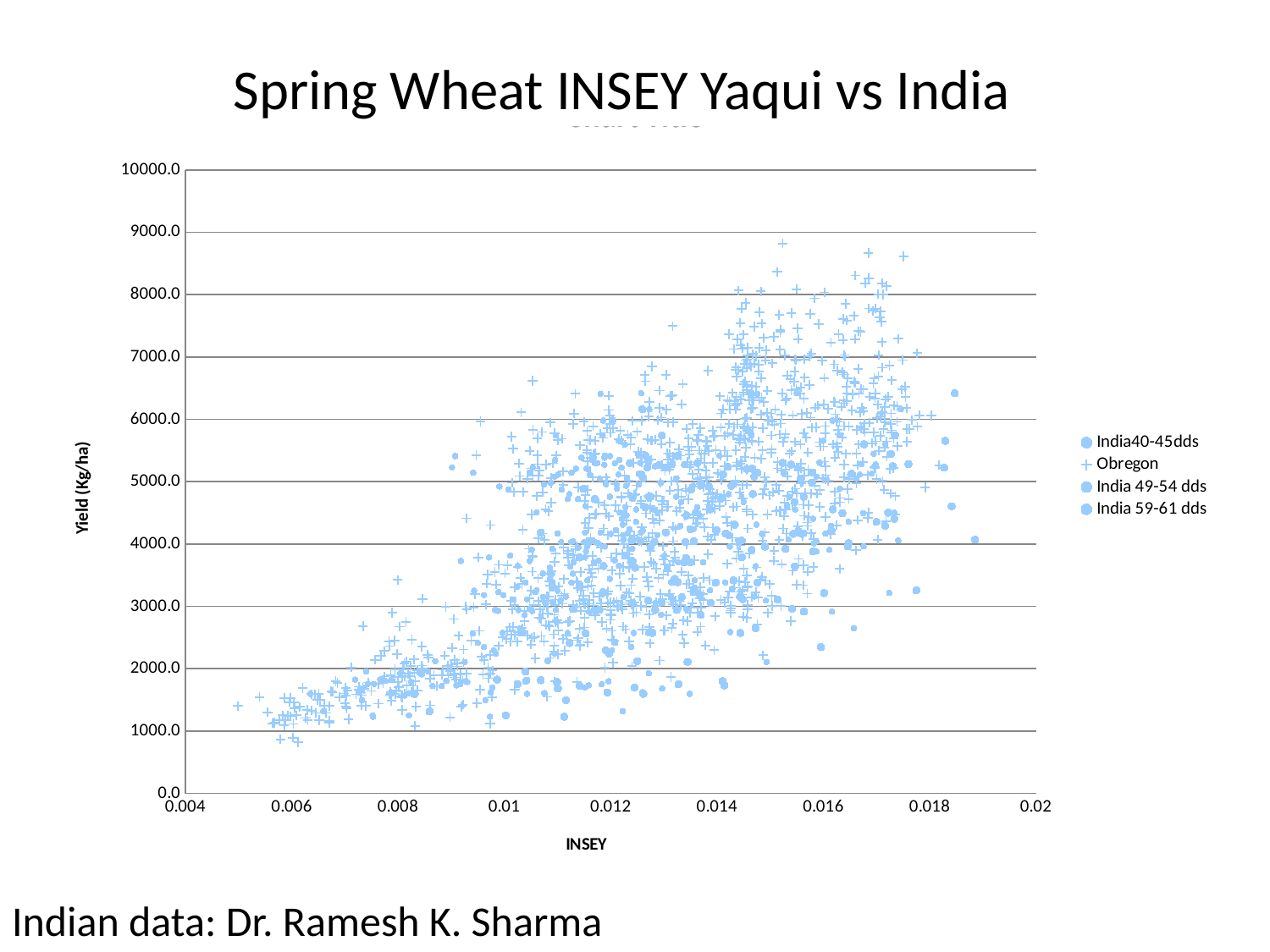
What is the maximum value shown on the vertical axis? 10000.0 Do yield values generally rise or fall as INSEY increases along the x axis? rise Is the lowest plotted yield value greater or less than 1000.0? less What is the maximum value shown on the horizontal INSEY axis? 0.02 What kind of chart is shown on the slide? scatter plot Is the highest plotted yield value greater or less than 9000.0? less What is the label on the vertical axis? Yield (Kg/ha) How many series does the legend list? 4